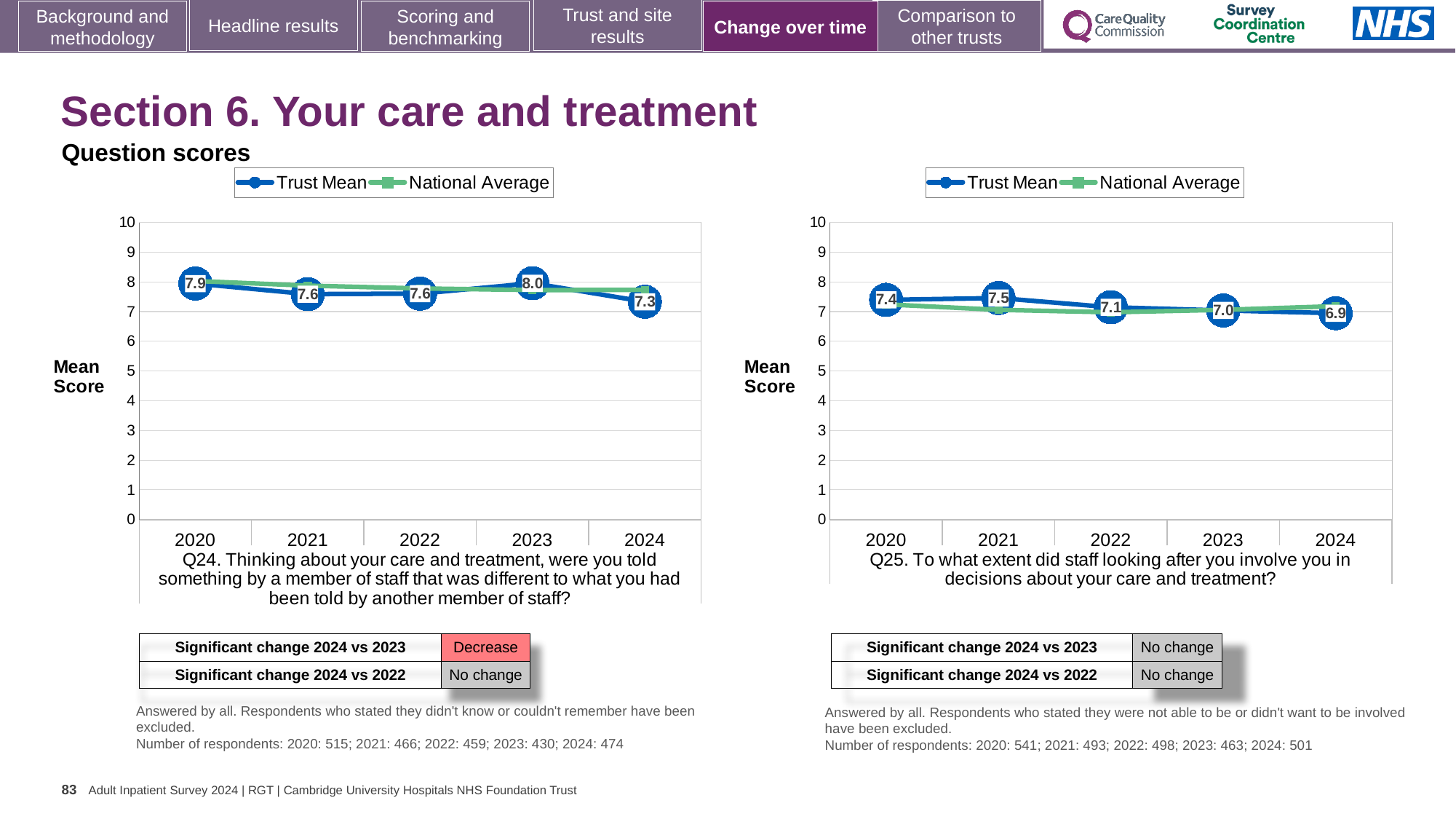
In the Q24 chart (left), what is the Trust Mean score for 2024? 7.3 In the Q24 chart (left), what is the difference between the Trust Mean scores for 2023 and 2024? 0.7 In the Q25 chart (right), what is the Trust Mean score for 2024? 6.9 What type of chart is used for the Q24 chart (left)? Line chart In the Q25 chart (right), is the Trust Mean score for 2021 higher or lower than for 2022? higher How many series does the legend of the Q25 chart (right) list? 2 How many years are plotted on the x axis of the Q24 chart (left)? 5 In the Q25 chart (right), what is the Trust Mean score for 2020? 7.4 In the Q25 chart (right), which year has the lowest Trust Mean score? 2024 In the Q25 chart (right), is the Trust Mean score for 2024 greater or less than 8? less In the Q24 chart (left), which year has the highest Trust Mean score? 2023 In the Q24 chart (left), what is the Trust Mean score for 2023? 8.0